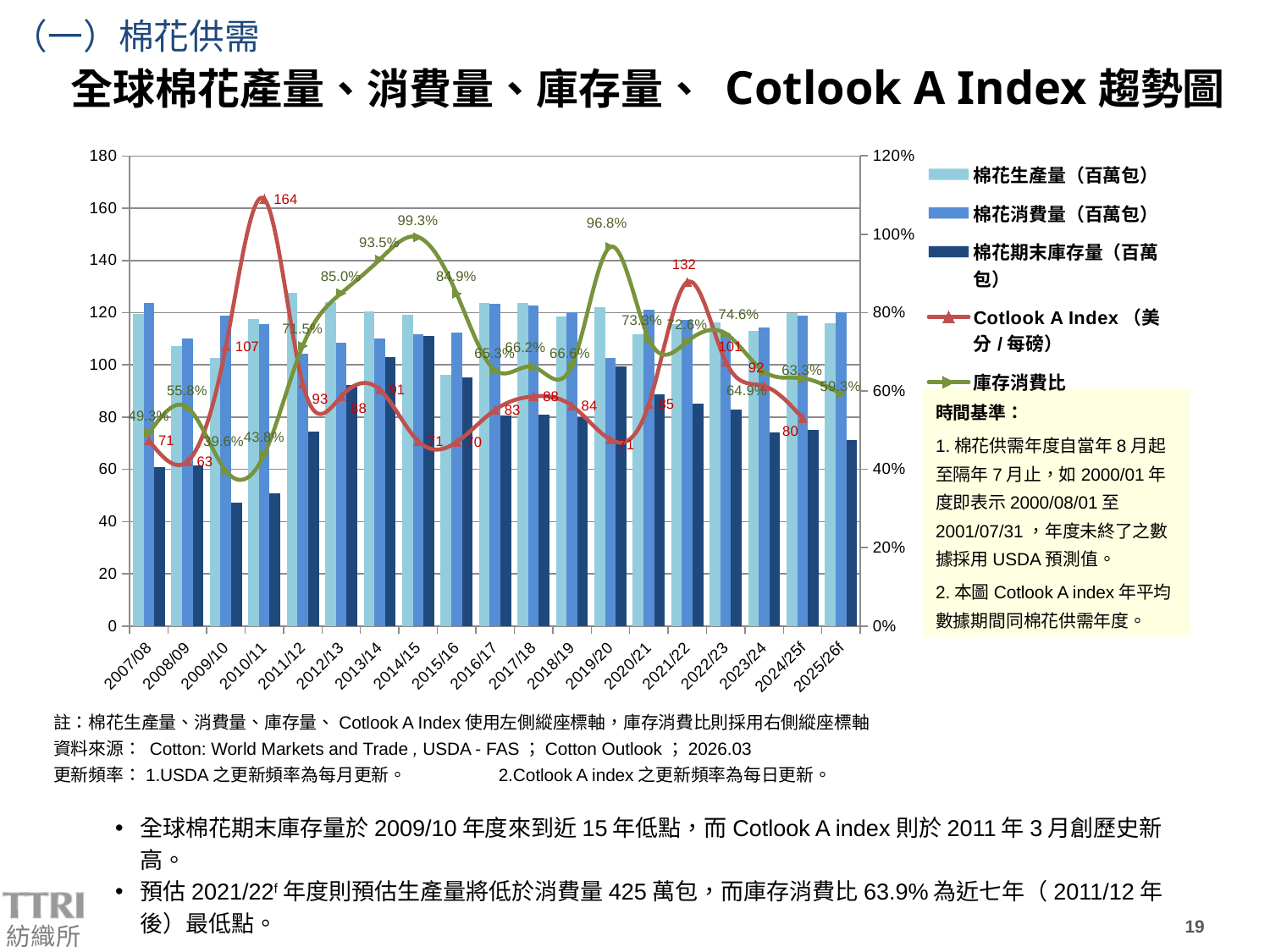
How many cotton years are shown on the x axis? 19 In which year is the Cotlook A Index at its lowest? 2008/09 What kind of chart is this? Combined bar and line chart What is the Cotlook A Index value for 2021/22? 132 In which year is the 庫存消費比 (stock-to-use ratio) at its lowest? 2009/10 What is the 庫存消費比 (stock-to-use ratio) for 2014/15? 99.3% Is the 棉花期末庫存量 (ending stocks) value for 2009/10 greater or less than 60? less What is the Cotlook A Index value for 2010/11? 164 Which year has the larger Cotlook A Index value, 2021/22 or 2022/23? 2021/22 How many series does the legend list? 5 What is the difference between the highest Cotlook A Index value (2010/11) and the lowest (2008/09)? 101 Does the Cotlook A Index rise or fall from 2021/22 to 2024/25f? fall